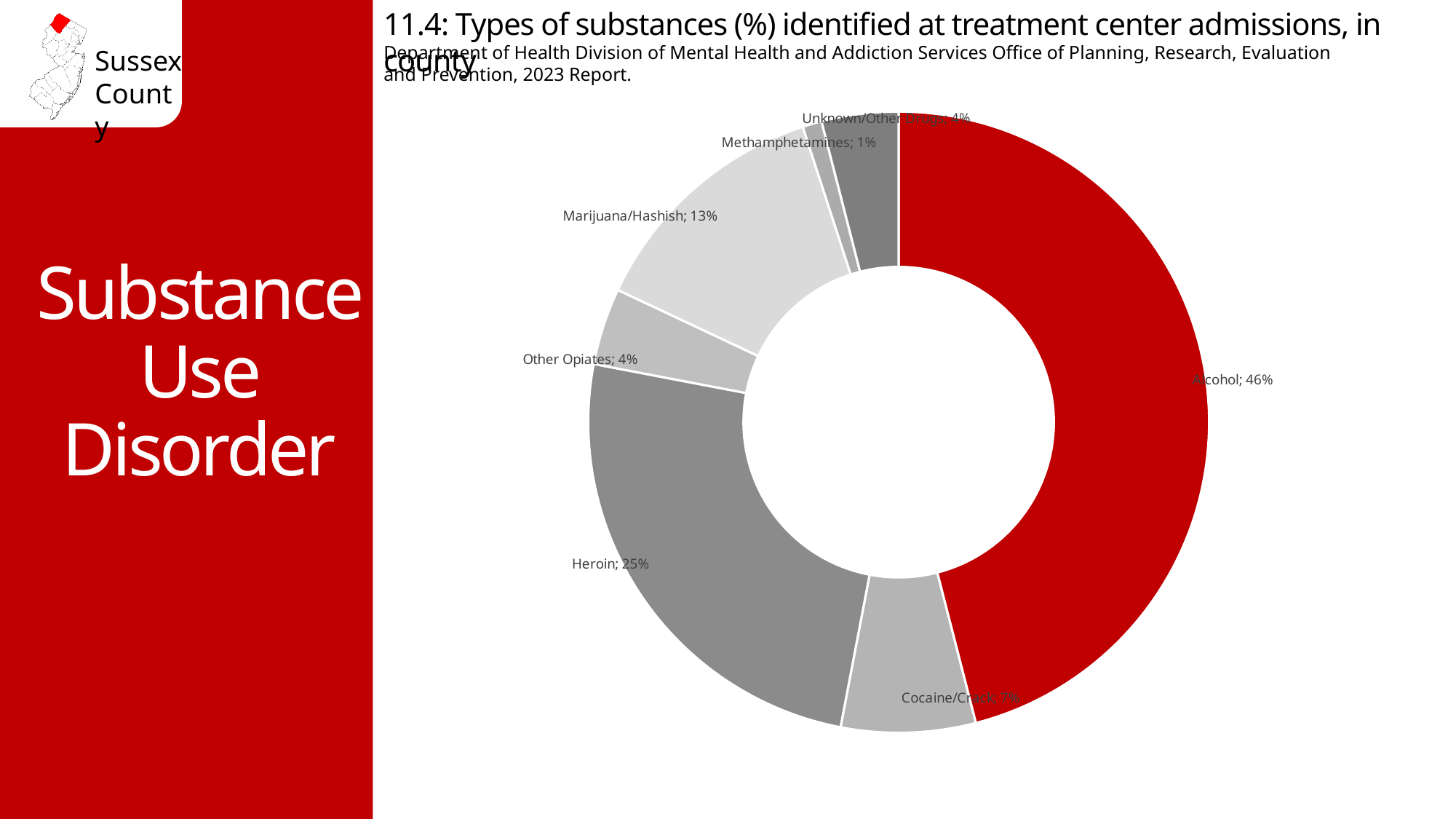
What percentage is shown for Methamphetamines? 1% What percentage is shown for Cocaine/Crack? 7% Which labeled substance has the smallest share of admissions? Methamphetamines What percentage is shown for Marijuana/Hashish? 13% What kind of chart is used on this slide? Doughnut (pie) chart Which is larger, the share for Marijuana/Hashish or the share for Cocaine/Crack? Marijuana/Hashish What percentage is shown for Heroin? 25% What is the difference in percentage points between Alcohol and Heroin? 21 Which slice of the chart is colored red? Alcohol What percentage of treatment center admissions identified Alcohol? 46% What percentage is shown for Other Opiates? 4% Which substance has the largest share of admissions? Alcohol